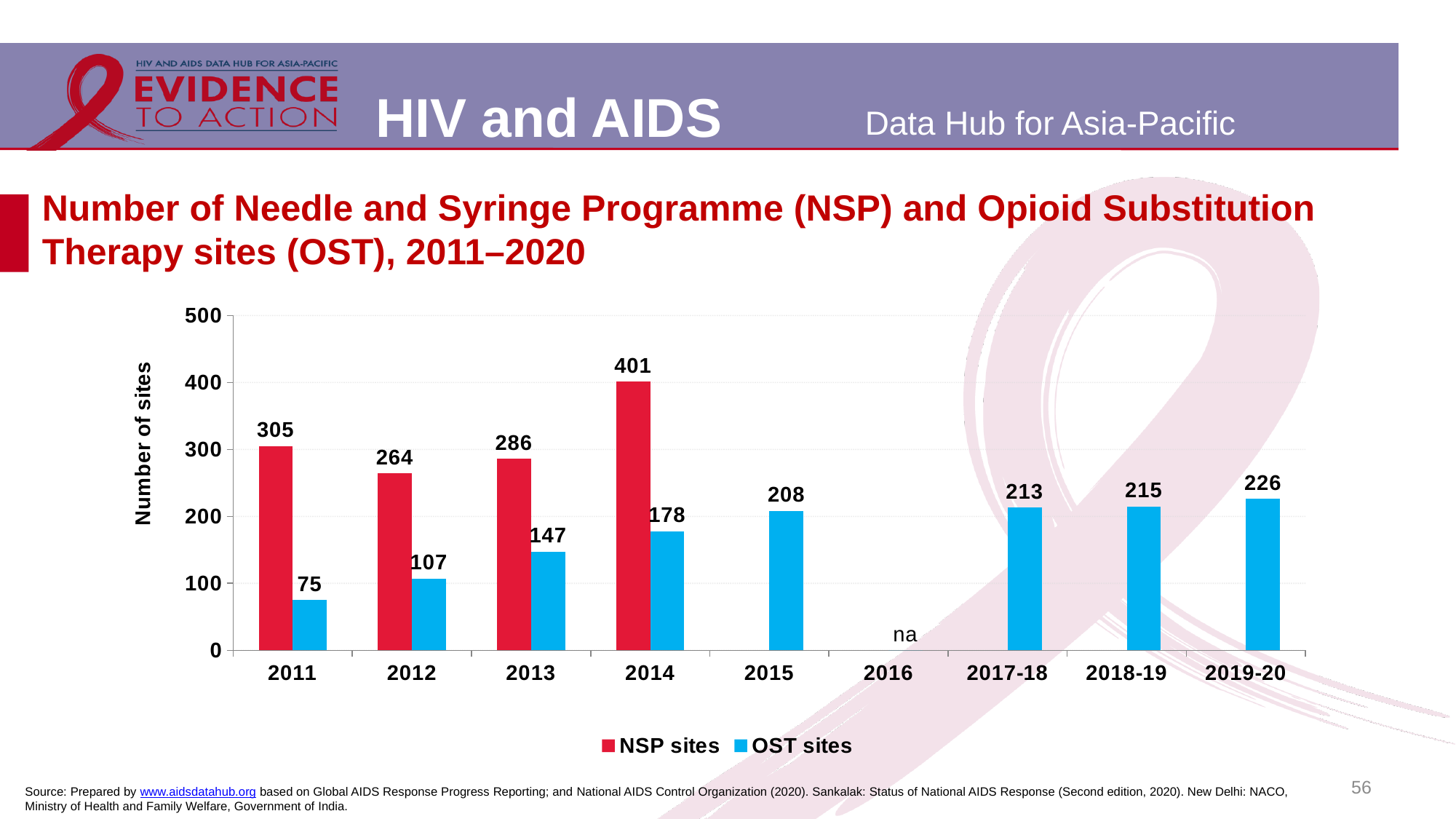
Which is larger: OST sites in 2015 or OST sites in 2017-18? OST sites in 2017-18 What is the difference between NSP sites and OST sites in 2013? 139 What label is shown for 2016 instead of a bar? na Do the OST sites values rise or fall from 2011 to 2014? Rise In which year was the number of OST sites lowest? 2011 How many OST sites were there in 2011? 75 What kind of chart is shown on the slide? Bar chart How many series does the legend list? 2 What is the value for OST sites in 2019-20? 226 In which year was the number of NSP sites highest? 2014 How many categories are shown on the x axis? 9 How many NSP sites were there in 2014? 401